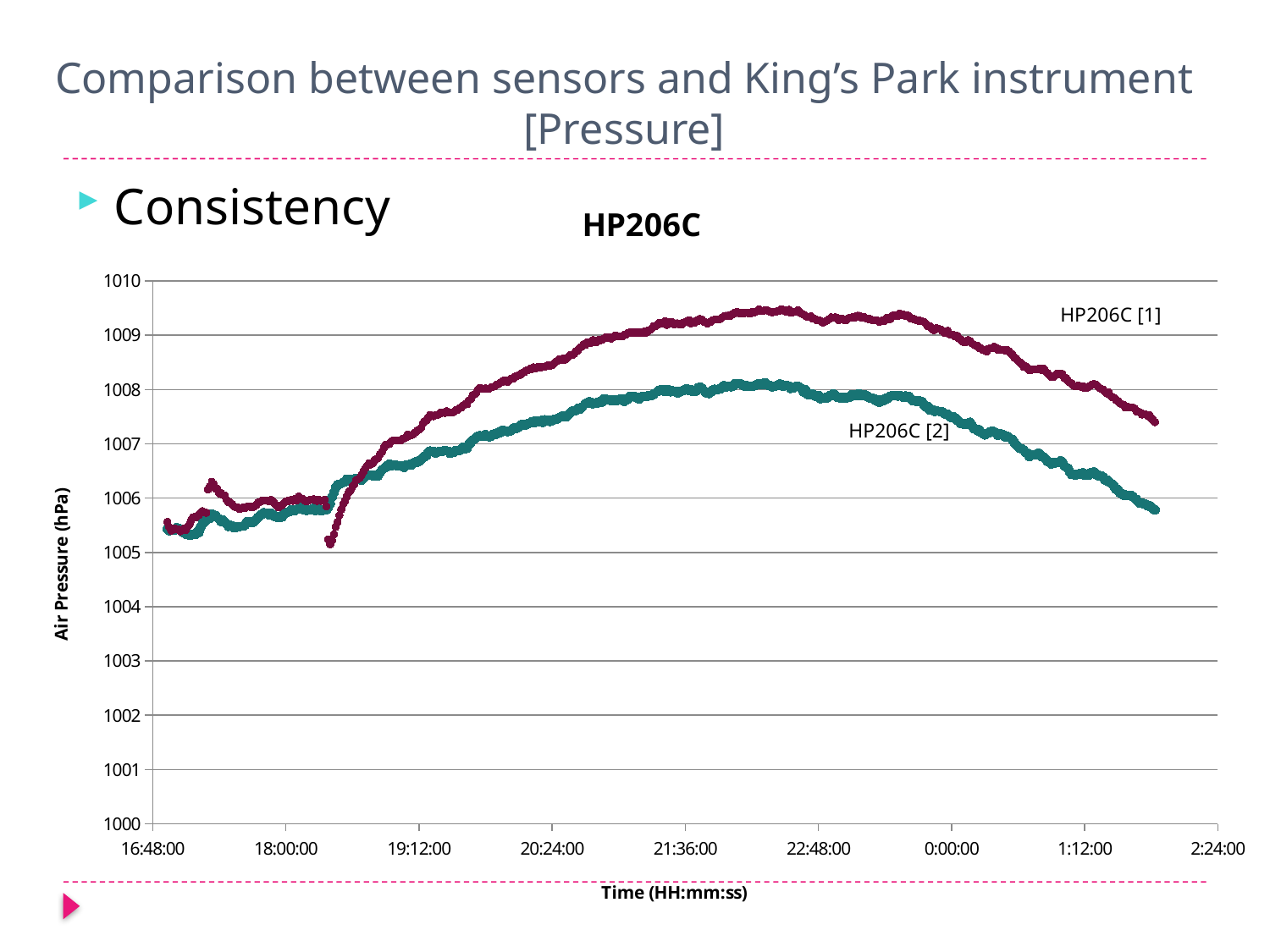
What kind of chart is shown on the slide? line chart At 22:48:00, which series has the higher air pressure, HP206C [1] or HP206C [2]? HP206C [1] Is the value of HP206C [1] at 22:48:00 greater or less than 1009? greater What is the label of the vertical axis? Air Pressure (hPa) What is the title of the chart? HP206C Is the value of HP206C [2] at 1:12:00 greater or less than 1007? less Do the air pressure values rise or fall between 0:00:00 and 1:12:00? fall Is the value of HP206C [2] at 22:48:00 greater or less than 1007? greater How many series are plotted on the HP206C chart? 2 Which series reaches the higher peak air pressure? HP206C [1]